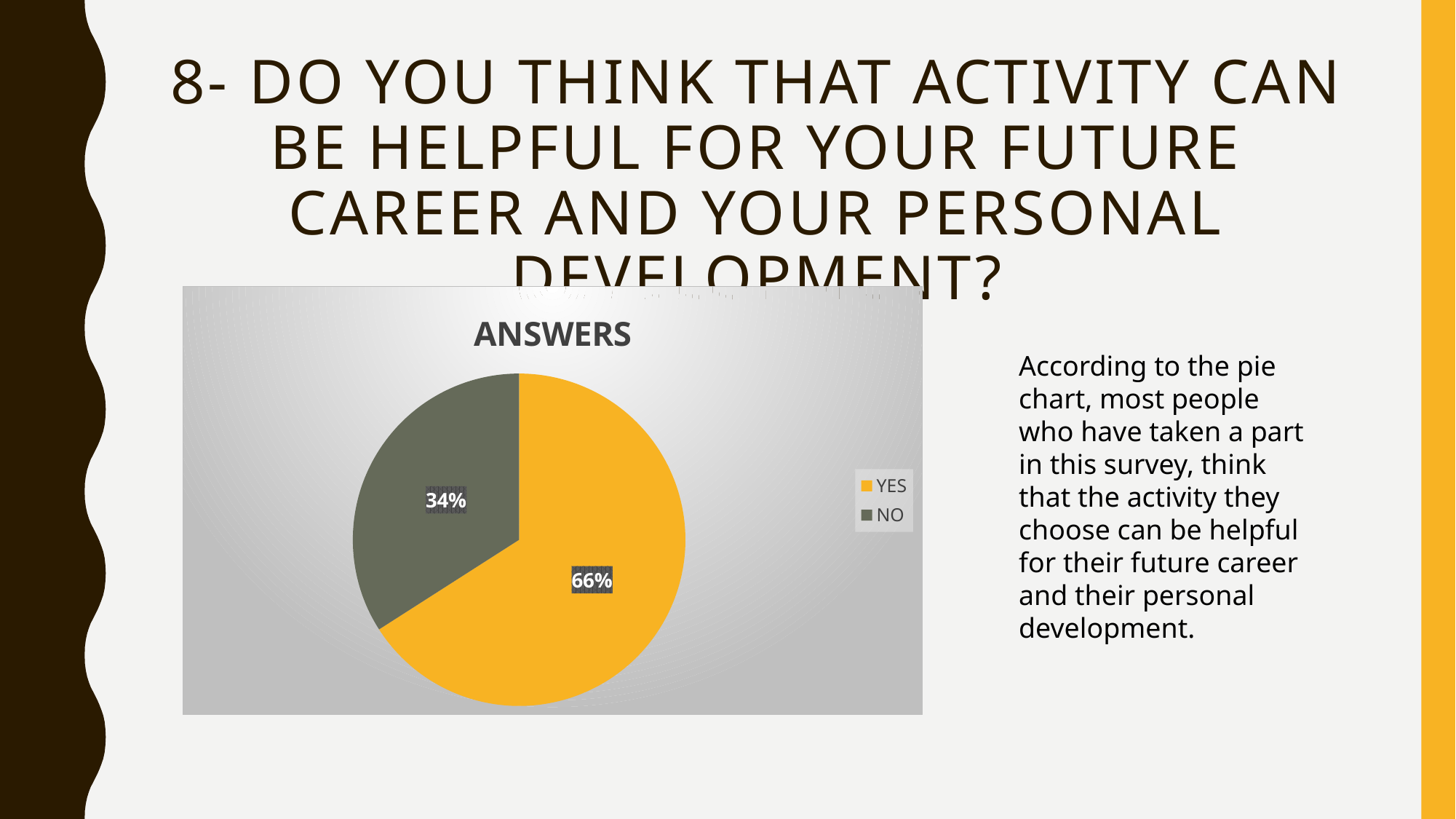
Which is larger, the YES share or the NO share? YES What colour is the YES slice? yellow What kind of chart is shown on the slide? pie chart What is the difference in percentage points between the YES and NO shares? 32 How many categories does the pie chart have? 2 What percentage of answers are NO? 34% What is the chart's title? ANSWERS Which answer has the largest share of the pie? YES What percentage of answers are YES? 66% How many entries does the legend list? 2 Which answer has the smallest share of the pie? NO Is the share for NO greater or less than 50%? less